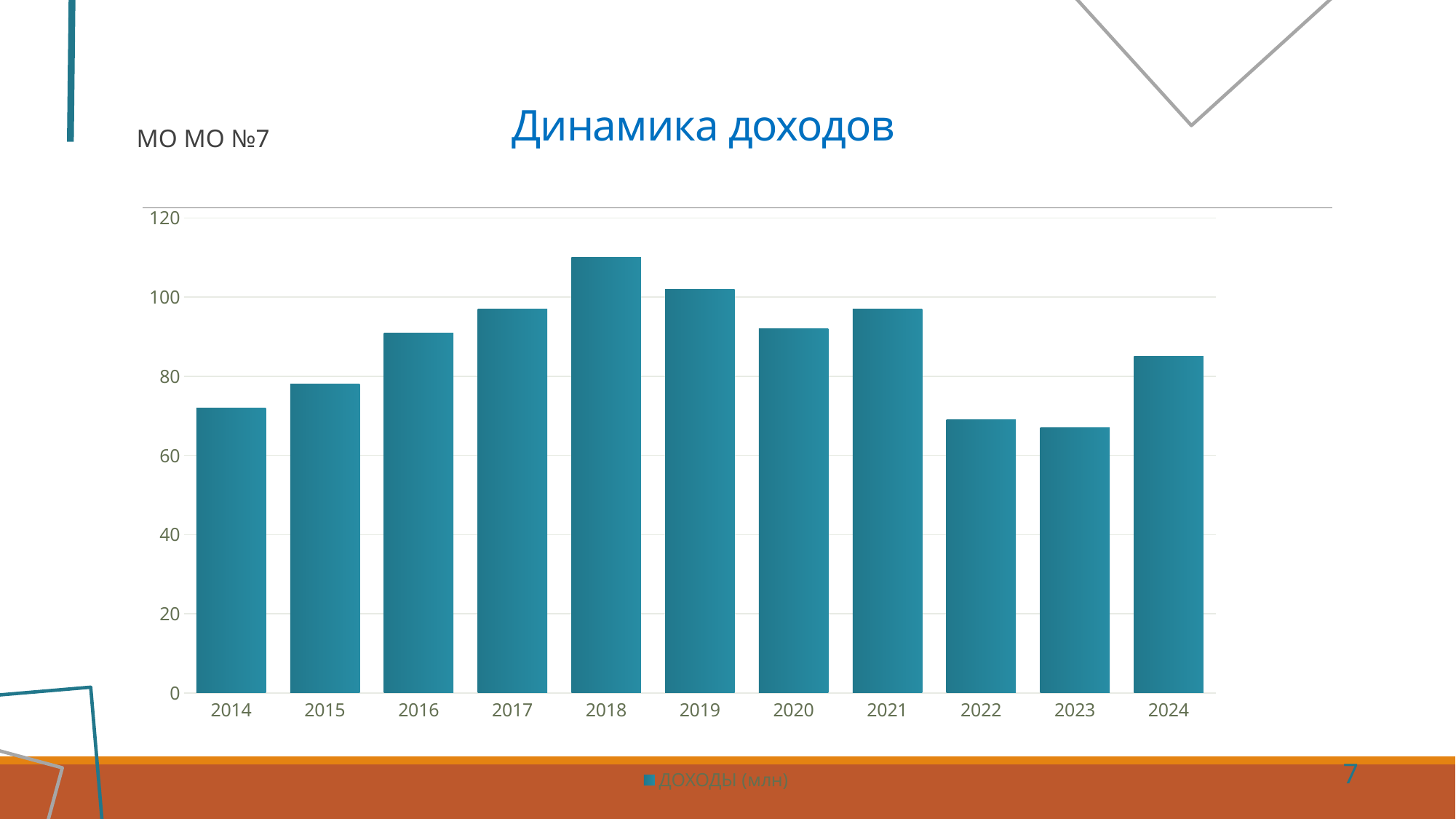
Is the value for 2014 greater or less than 80? less Do the values rise or fall from 2014 to 2018? rise Is the value for 2022 greater or less than 80? less How many years are shown on the x axis of the chart? 11 Which year has the highest value in the chart? 2018 What is the name of the series shown in the legend? ДОХОДЫ (млн) What type of chart is shown on the slide? Bar chart How many series does the legend list? 1 What is the title of the chart? Динамика доходов Which is larger, the value for 2018 or the value for 2019? 2018 Is the value for 2020 greater or less than 100? less